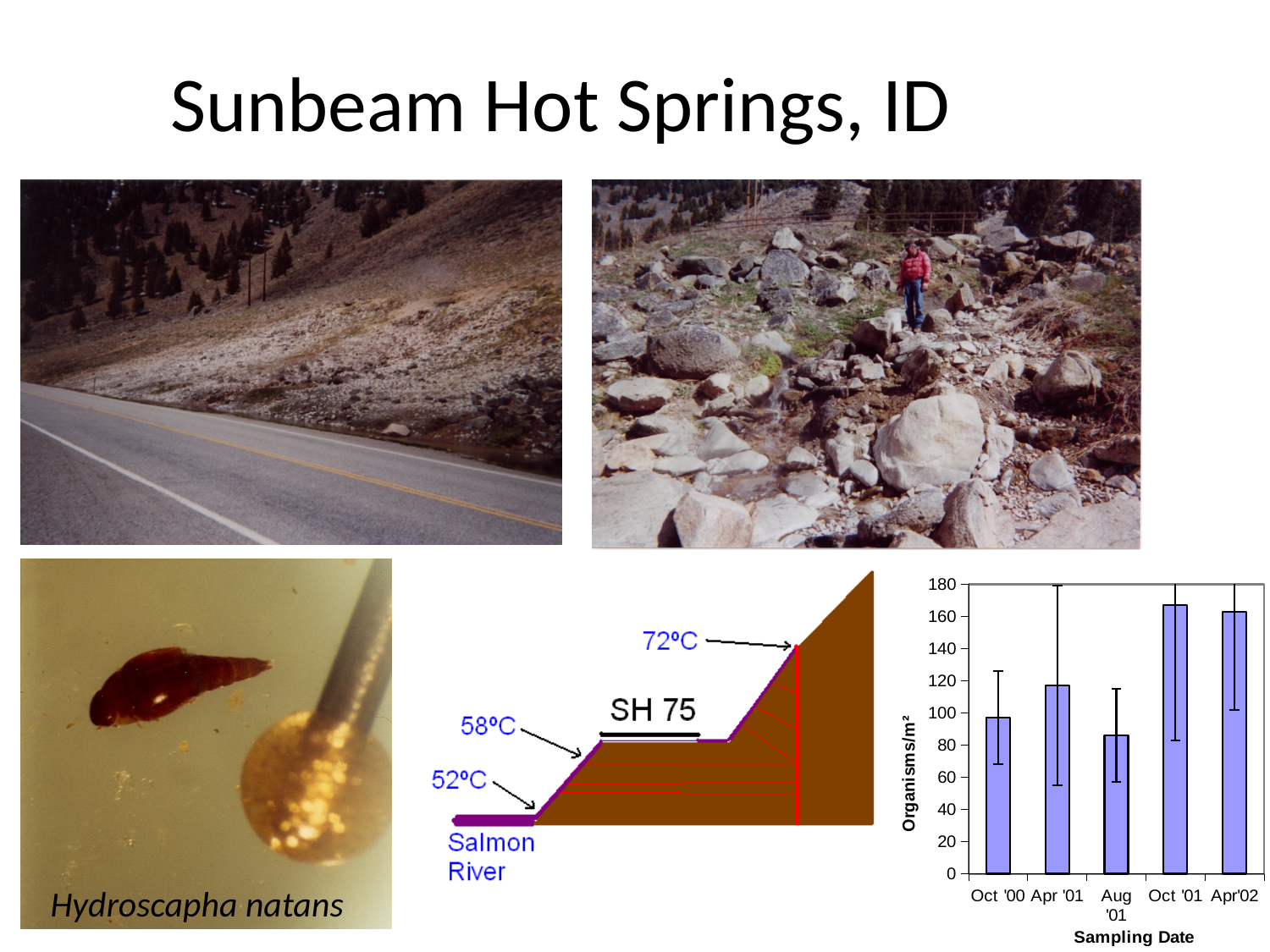
Is the value for Aug '01 in the bar chart greater or less than 100? less What is the label of the vertical axis of the bar chart? Organisms/m² In the bar chart, which is larger, the value for Apr '01 or the value for Aug '01? Apr '01 What kind of chart is shown at the bottom right of the slide? bar chart Is the value for Apr'02 in the bar chart greater or less than 140? greater What is the label of the horizontal axis of the bar chart? Sampling Date How many sampling dates are plotted in the bar chart? 5 Is the value for Oct '01 in the bar chart greater or less than 140? greater In the bar chart, which is larger, the value for Oct '00 or the value for Oct '01? Oct '01 Which sampling date has the lowest value in the bar chart? Aug '01